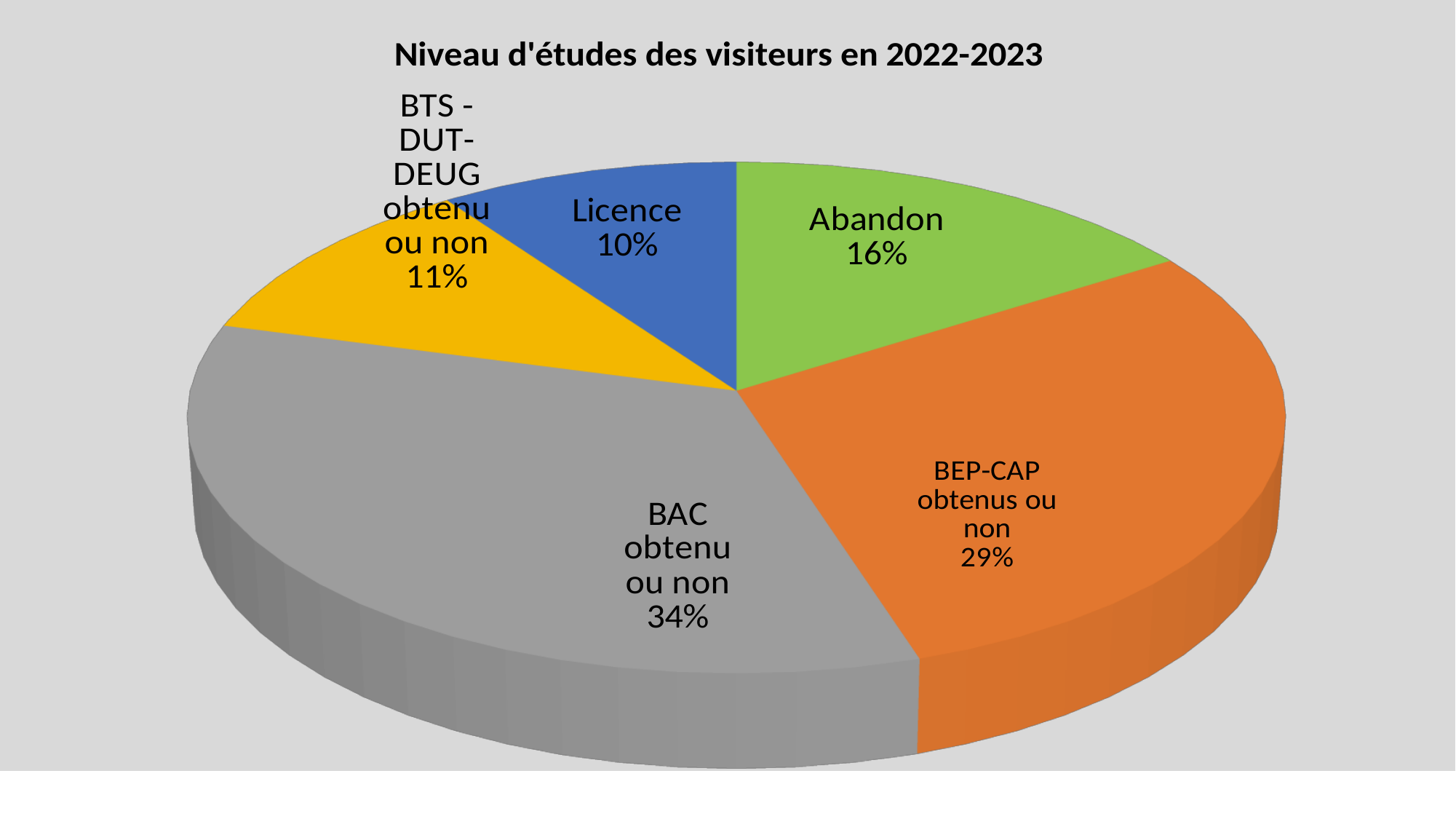
What share of visitors is shown for 'BAC obtenu ou non'? 34% What share of visitors is shown for 'BTS - DUT- DEUG obtenu ou non'? 11% What is the title of the chart? Niveau d'études des visiteurs en 2022-2023 What kind of chart is shown on the slide? pie chart What is the difference in percentage points between 'BAC obtenu ou non' and 'BEP-CAP obtenus ou non'? 5 What share of visitors is shown for 'Licence'? 10% Which is larger, the share for 'Abandon' or the share for 'Licence'? Abandon Which category has the smallest share of the pie? Licence What share of visitors is shown for 'BEP-CAP obtenus ou non'? 29% What share of visitors is shown for 'Abandon'? 16% Which category has the largest share of the pie? BAC obtenu ou non How many categories are shown in the pie chart? 5